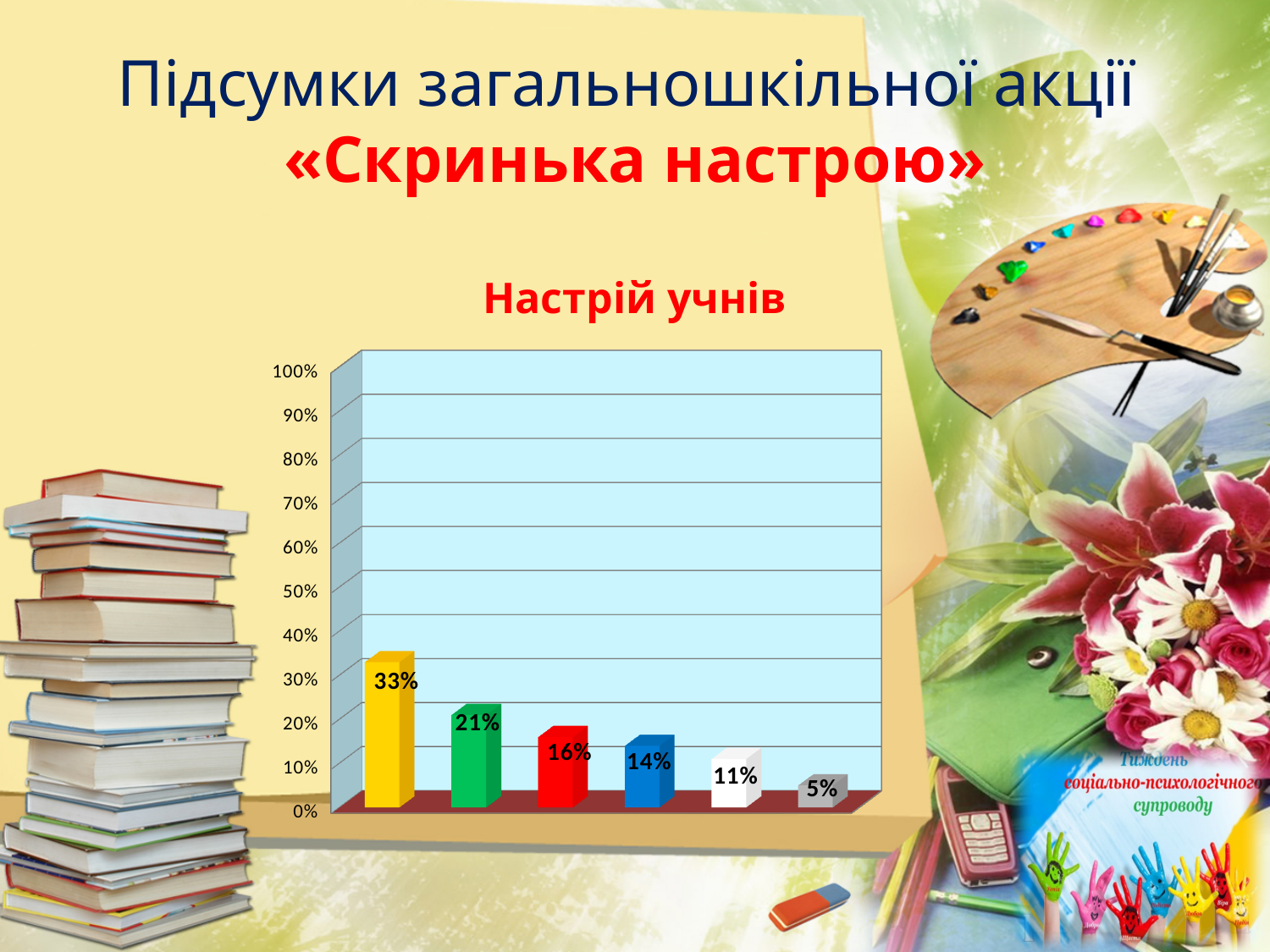
What is the difference between the yellow bar and the green bar? 12% What type of chart is shown on the slide? bar chart What value is shown on the yellow bar? 33% What value is shown on the blue bar? 14% What is the title of the chart? Настрій учнів Which bar has the highest value? the yellow bar (33%) What value is shown on the green bar? 21% Do the bar values rise or fall from left to right? fall Which bar has the lowest value? the grey bar (5%) What value is shown on the red bar? 16% How many bars are plotted in the chart? 6 What value is shown on the grey bar? 5%